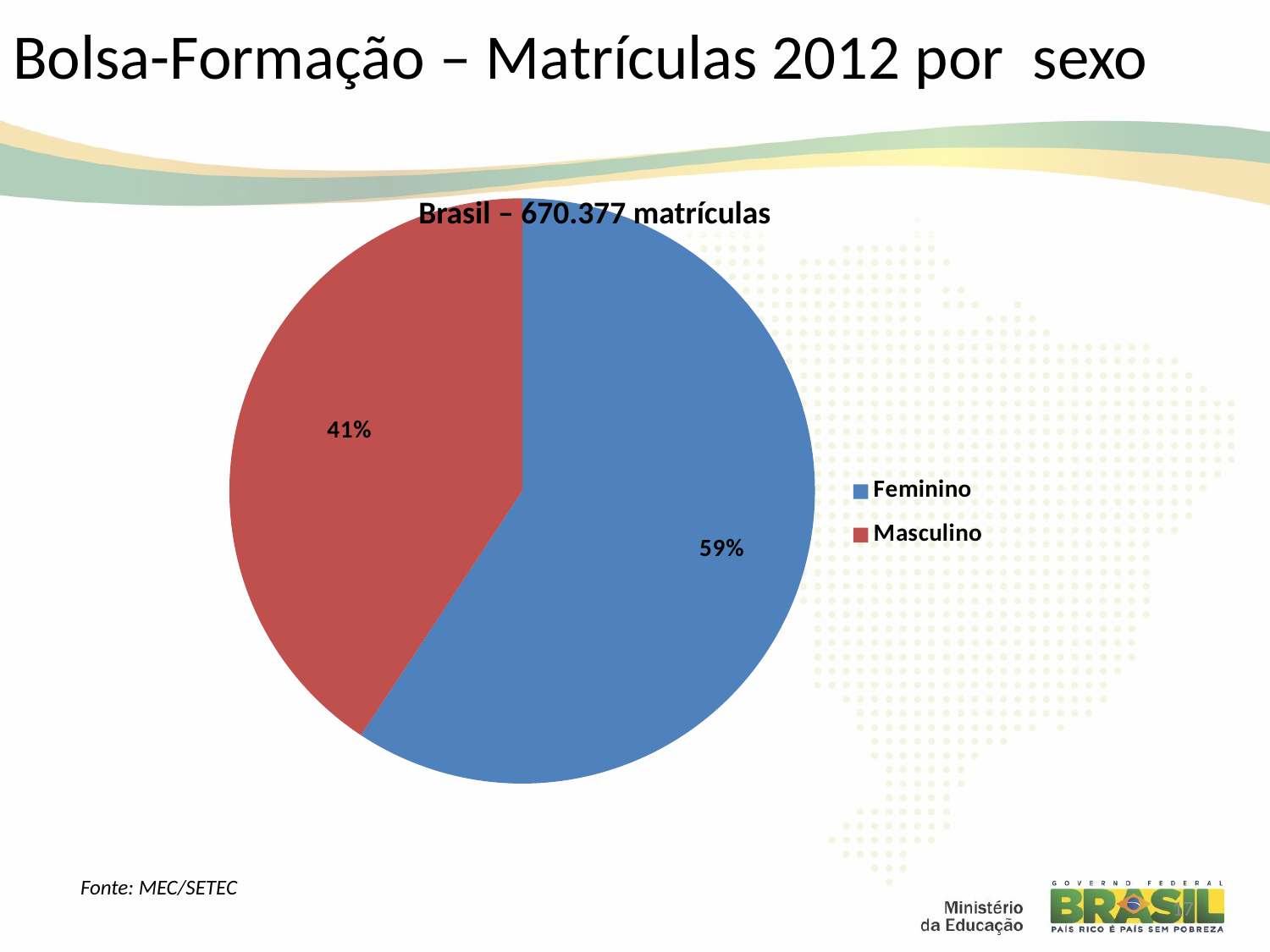
Is the share for Feminino greater or less than 50%? greater How many slices does the pie chart have? 2 What kind of chart is shown on the slide? Pie chart What colour is the Masculino slice? Red Which category has the smallest slice of the pie? Masculino What is the difference in percentage points between the Feminino and Masculino slices? 18 What share of the pie does Masculino represent? 41% What share of the pie does Feminino represent? 59% Which category has the largest slice of the pie? Feminino Which slice is larger, Feminino or Masculino? Feminino What is the title of the chart? Brasil – 670.377 matrículas How many entries does the legend list? 2